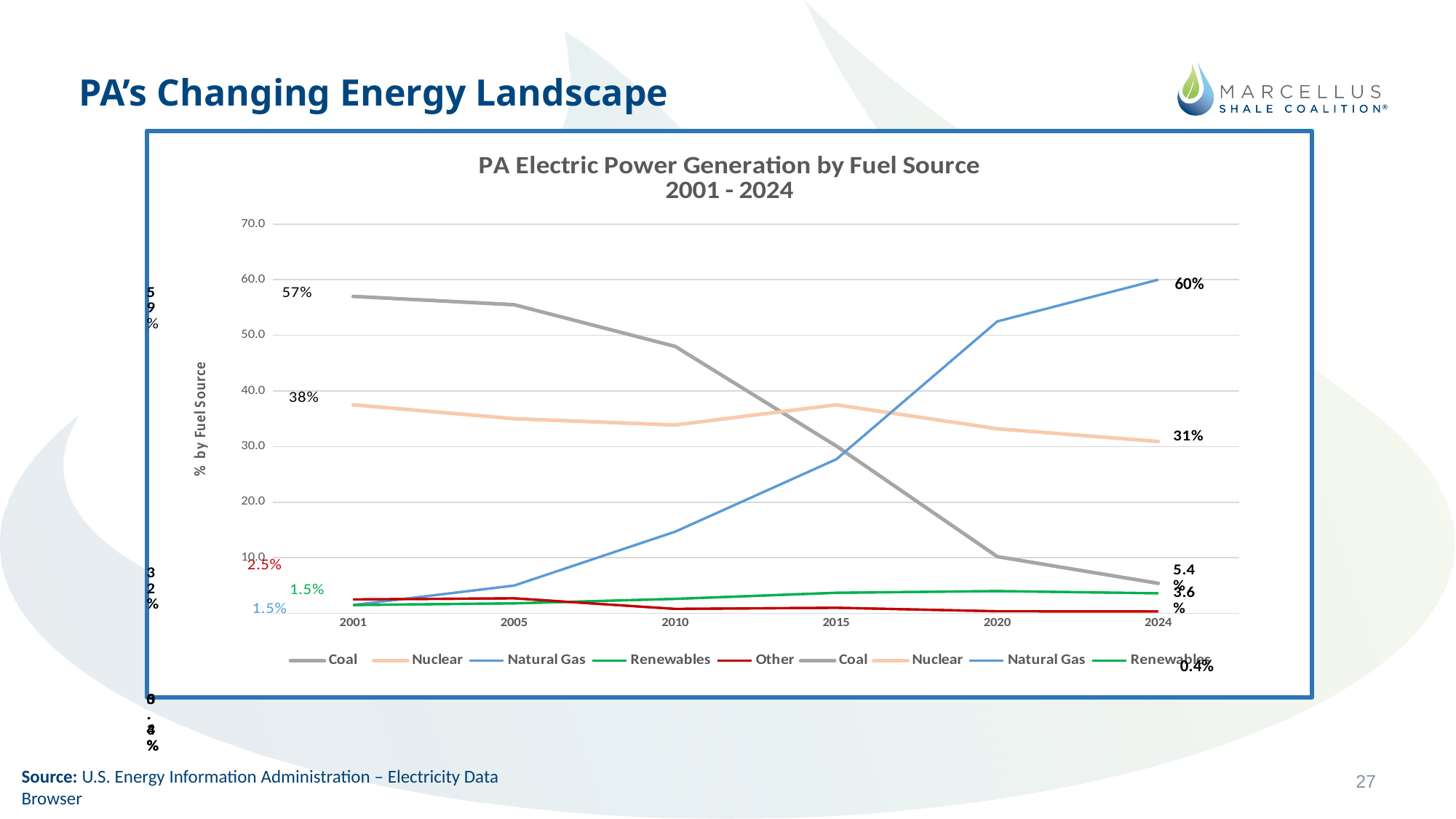
What was Nuclear's share in 2024? 31% What was Natural Gas's share of PA electric power generation in 2024? 60% What was Coal's share of PA electric power generation in 2001? 57% Which was larger in 2024, Nuclear or Coal? Nuclear Which fuel source had the highest share in 2024? Natural Gas What was Nuclear's share in 2001? 38% By how many percentage points did Coal's share fall from 2001 to 2024? 51.6 percentage points Is the value for Coal in 2010 greater or less than 40? greater What kind of chart is shown? Line chart How many years are labeled on the x axis? 6 Which fuel source had the highest share in 2001? Coal What was the Renewables share in 2024? 3.6%